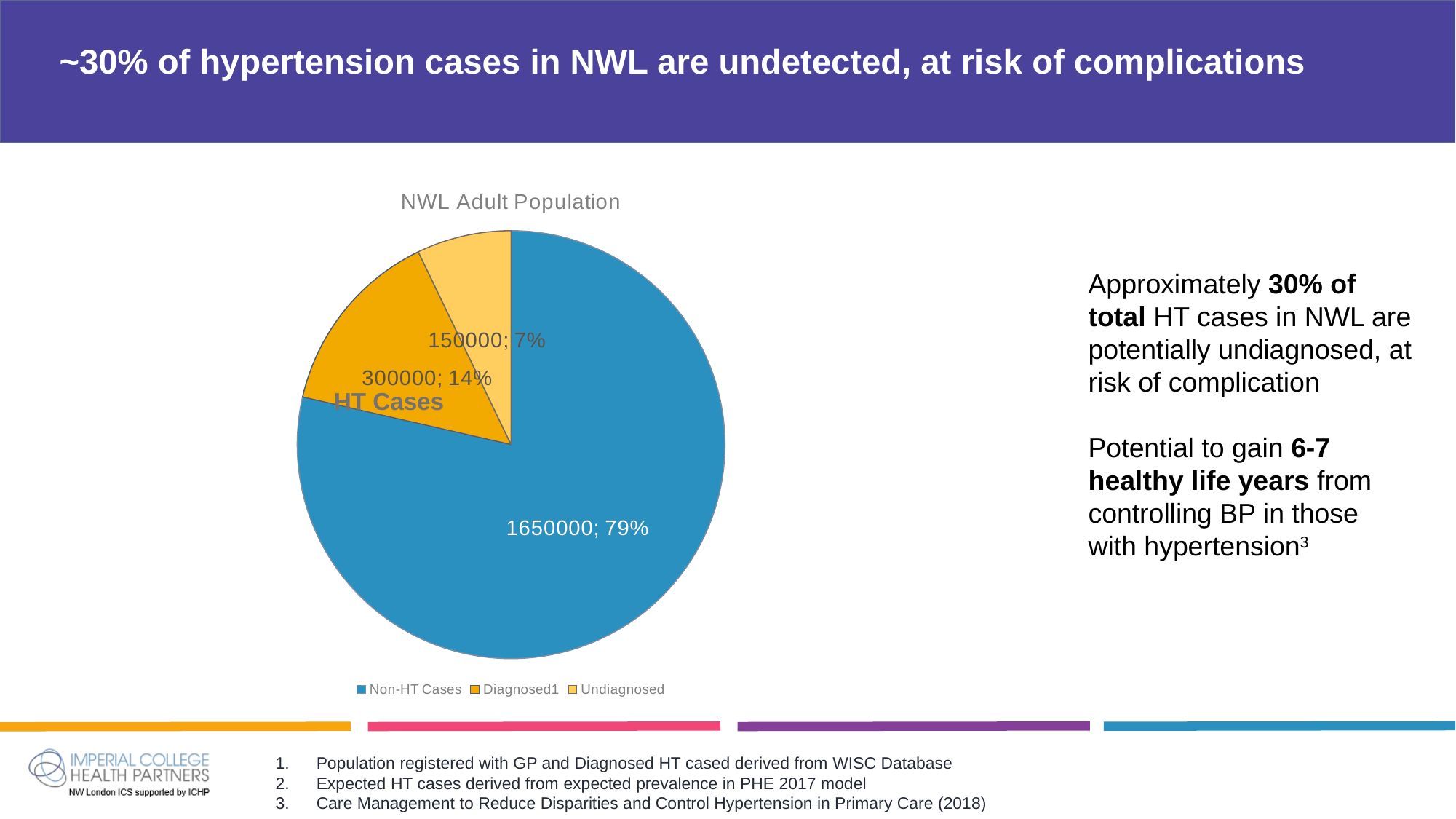
What is the value for Diagnosed1? 300000 What share of the pie is Undiagnosed? 7% What is the value for Undiagnosed? 150000 Which category has the smallest slice? Undiagnosed What type of chart is shown on the slide? pie chart How many entries does the legend list? 3 What share of the pie is Diagnosed1? 14% What is the difference between the Diagnosed1 and Undiagnosed values? 150000 What is the value for Non-HT Cases? 1650000 What is the title of the chart? NWL Adult Population Which category has the largest slice? Non-HT Cases How many slices does the pie chart have? 3